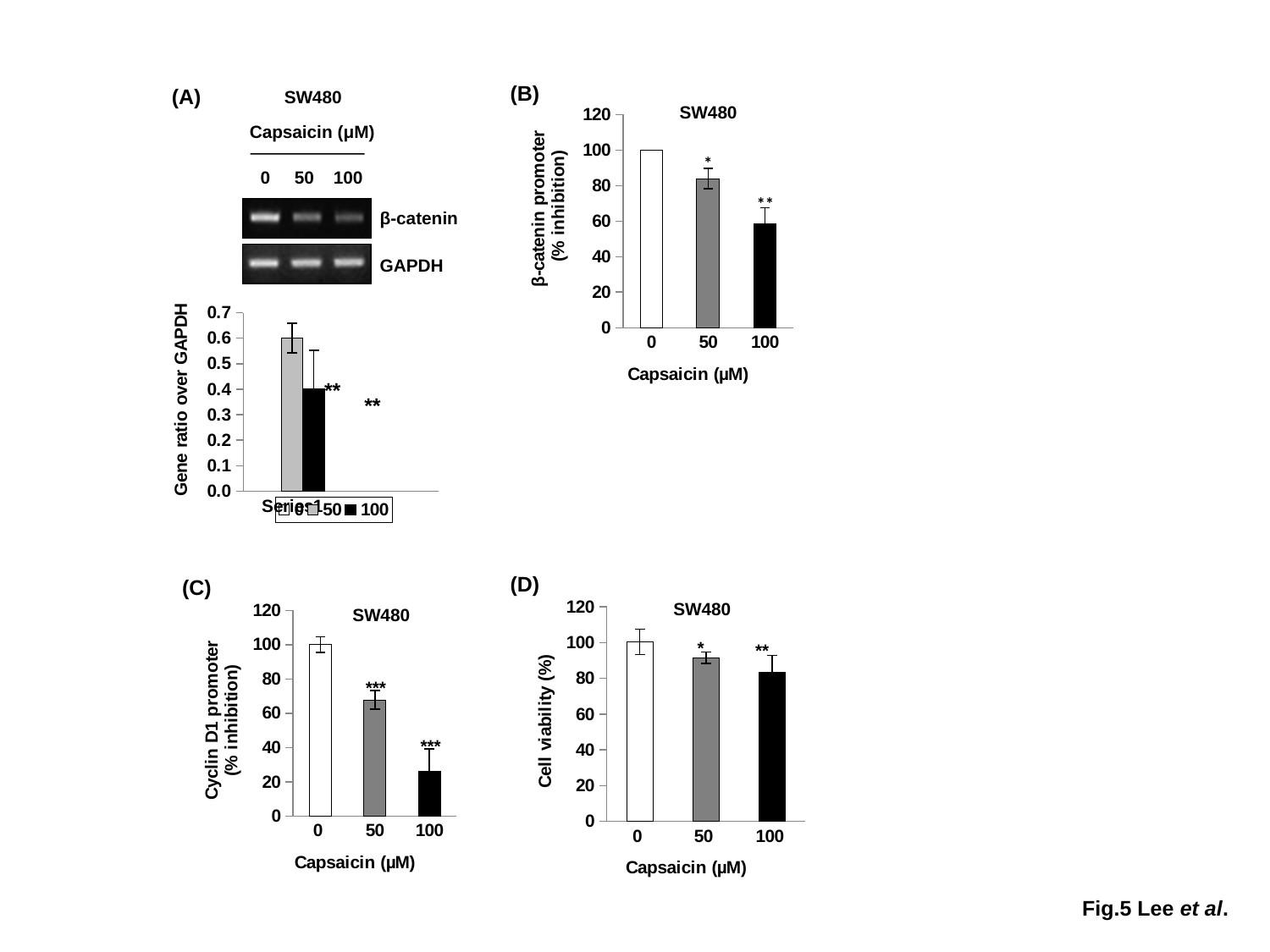
In panel (C), which is larger, the value for 50 µM or for 100 µM capsaicin? 50 µM In panel (B), what kind of chart is shown? bar chart In panel (C), how many capsaicin concentrations are plotted on the x axis? 3 In panel (D), do the cell viability values rise or fall as capsaicin concentration increases? fall In panel (D), is the cell viability for 100 µM capsaicin greater or less than 60? greater In panel (B), which capsaicin concentration has the lowest β-catenin promoter value? 100 In panel (C), which capsaicin concentration has the highest Cyclin D1 promoter value? 0 In panel (C), is the value for 50 µM capsaicin greater or less than 80? less In panel (D), what is the y-axis title? Cell viability (%) In panel (B), what is the x-axis title? Capsaicin (µM) In panel (C), is the value for 100 µM capsaicin greater or less than 40? less